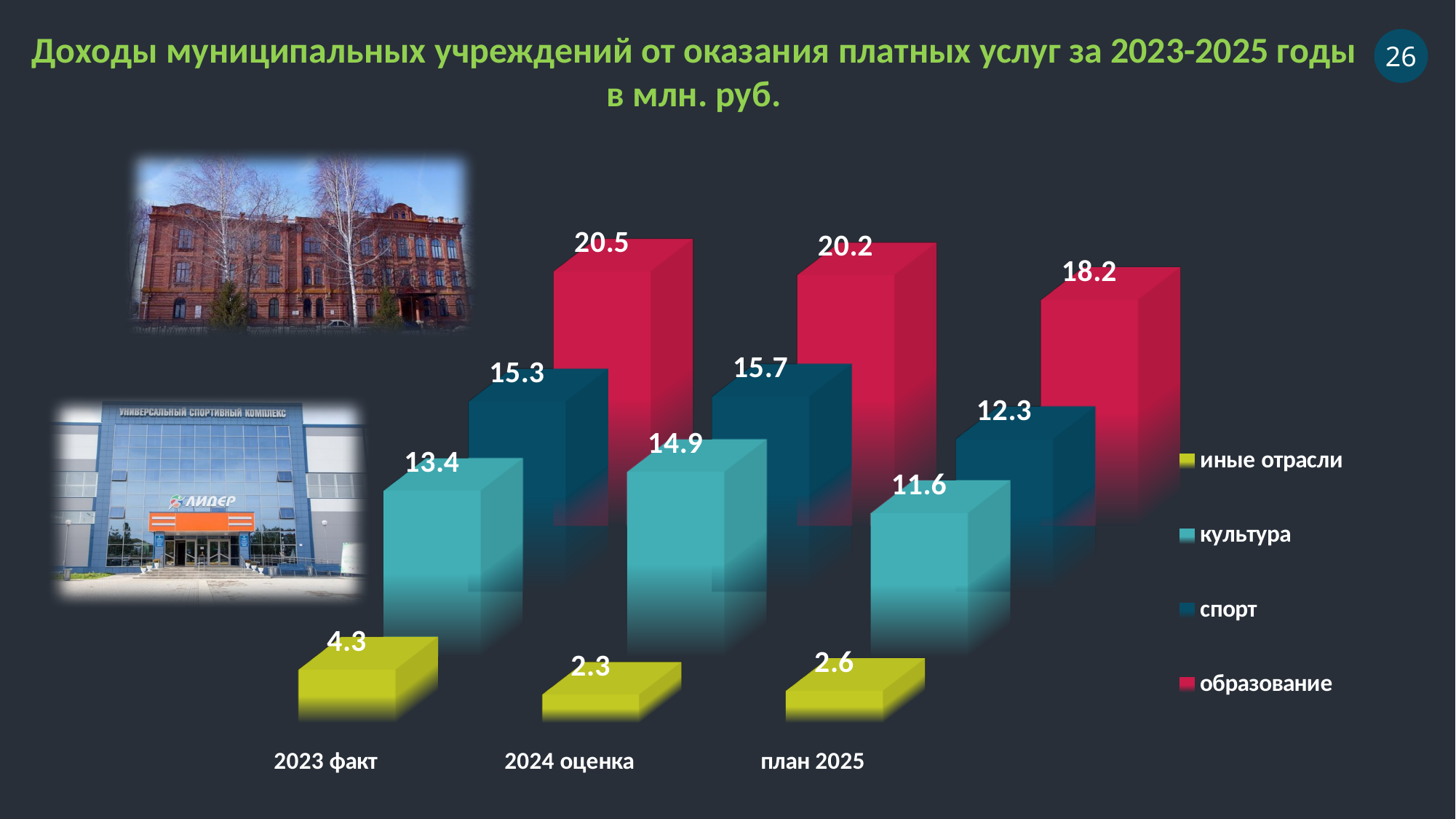
Which series has the lowest value in 2023 факт? иные отрасли What is the difference between the образование values for 2023 факт and план 2025? 2.3 How many series does the legend list? 4 What is the value for иные отрасли in план 2025? 2.6 Which is larger: культура in 2023 факт or культура in 2024 оценка? 2024 оценка Does the value for спорт rise or fall from 2024 оценка to план 2025? fall What is the value for образование in 2023 факт? 20.5 Which series has the highest value in 2024 оценка? образование What kind of chart is shown on the slide? bar chart How many categories are shown on the x axis? 3 What is the value for культура in 2024 оценка? 14.9 What is the value for спорт in план 2025? 12.3